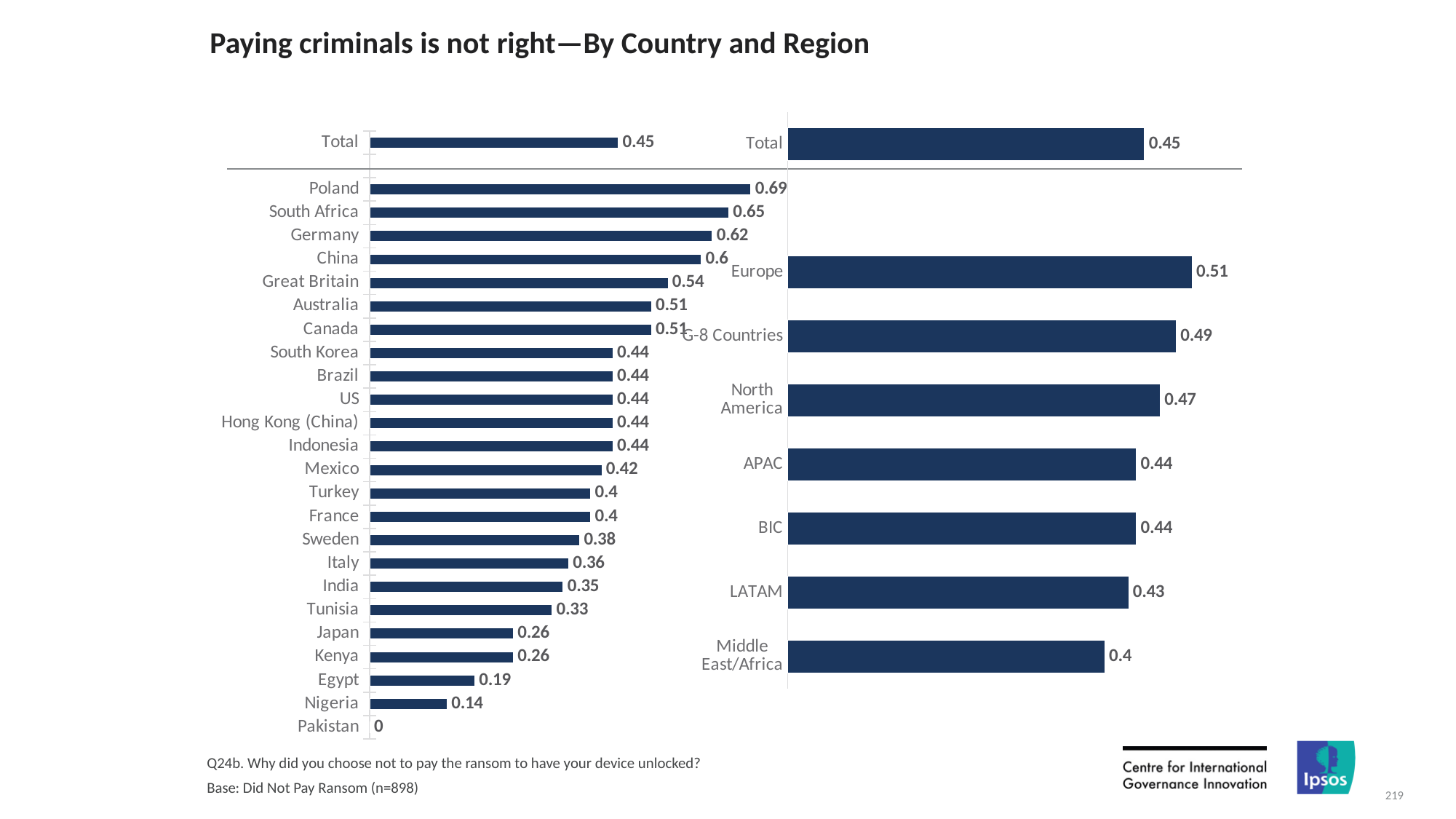
In the right chart (by region), how many regions are shown, excluding the Total bar? 7 In the right chart (by region), what is the difference between the values for Europe and LATAM? 0.08 In the left chart (by country), what is the value for Japan? 0.26 In the left chart (by country), which country has the lowest value? Pakistan In the left chart (by country), what is the value for Poland? 0.69 In the left chart (by country), which has a larger value, South Africa or Great Britain? South Africa In the left chart (by country), which country has the highest value? Poland In the left chart (by country), what is the difference between the values for Germany and Italy? 0.26 In the right chart (by region), what is the value for North America? 0.47 In the right chart (by region), which region has the lowest value? Middle East/Africa In the right chart (by region), which region has the highest value? Europe What type of chart is used on this slide? Bar chart